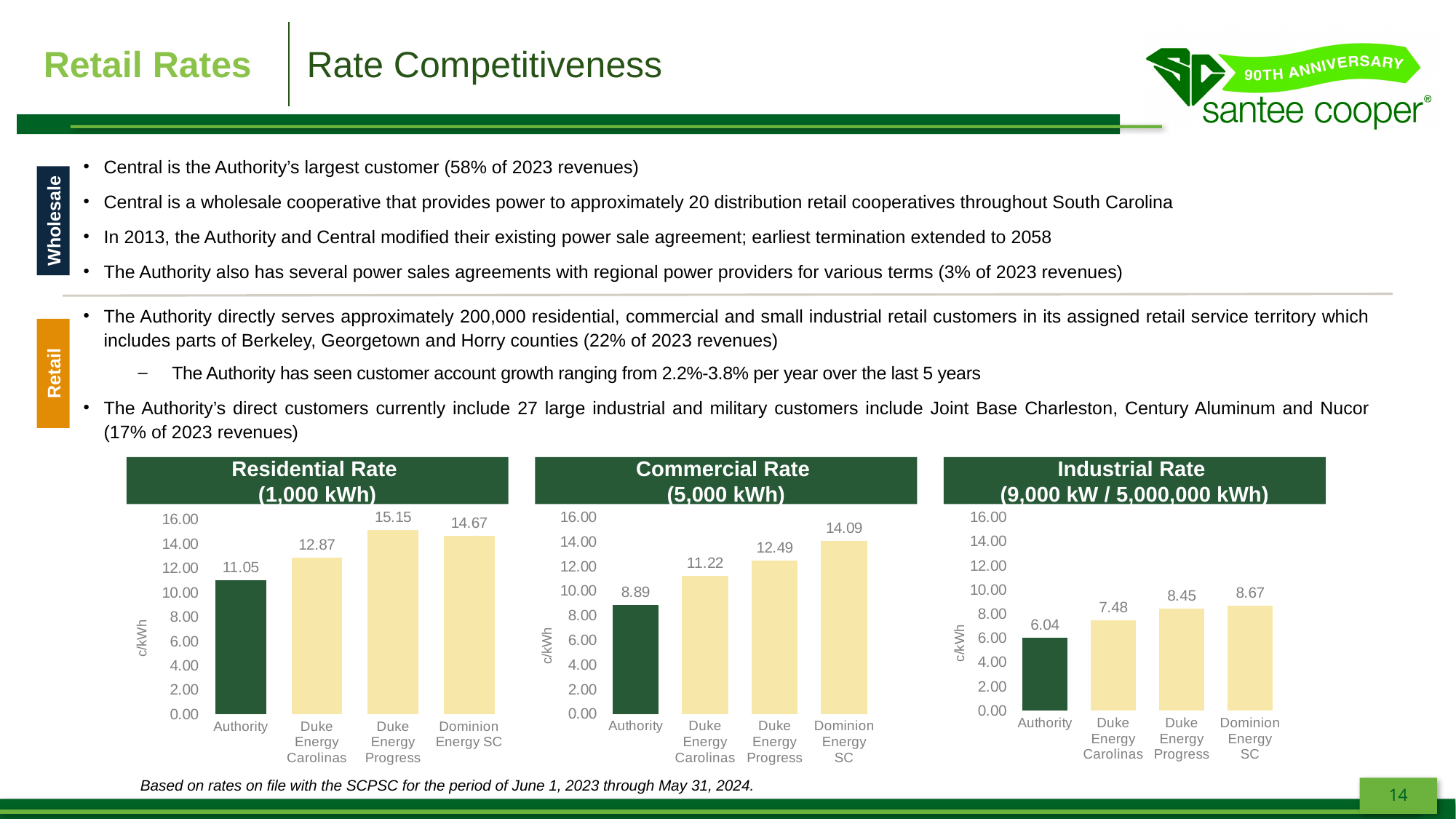
In the Residential Rate (1,000 kWh) chart, what is the difference between Duke Energy Progress and Authority? 4.10 In the Industrial Rate (9,000 kW / 5,000,000 kWh) chart, is the value for Authority greater or less than 8.00? less What unit is shown on the y axis of the Industrial Rate (9,000 kW / 5,000,000 kWh) chart? c/kWh What kind of chart is the Residential Rate (1,000 kWh) chart? Bar chart In the Industrial Rate (9,000 kW / 5,000,000 kWh) chart, what is the value for Duke Energy Carolinas? 7.48 In the Residential Rate (1,000 kWh) chart, which category has the highest value? Duke Energy Progress In the Industrial Rate (9,000 kW / 5,000,000 kWh) chart, what is the difference between Dominion Energy SC and Authority? 2.63 In the Commercial Rate (5,000 kWh) chart, which is larger, Duke Energy Carolinas or Duke Energy Progress? Duke Energy Progress In the Commercial Rate (5,000 kWh) chart, which category has the lowest value? Authority How many categories are shown in the Commercial Rate (5,000 kWh) chart? 4 In the Commercial Rate (5,000 kWh) chart, what is the value for Dominion Energy SC? 14.09 In the Residential Rate (1,000 kWh) chart, what is the value for Authority? 11.05